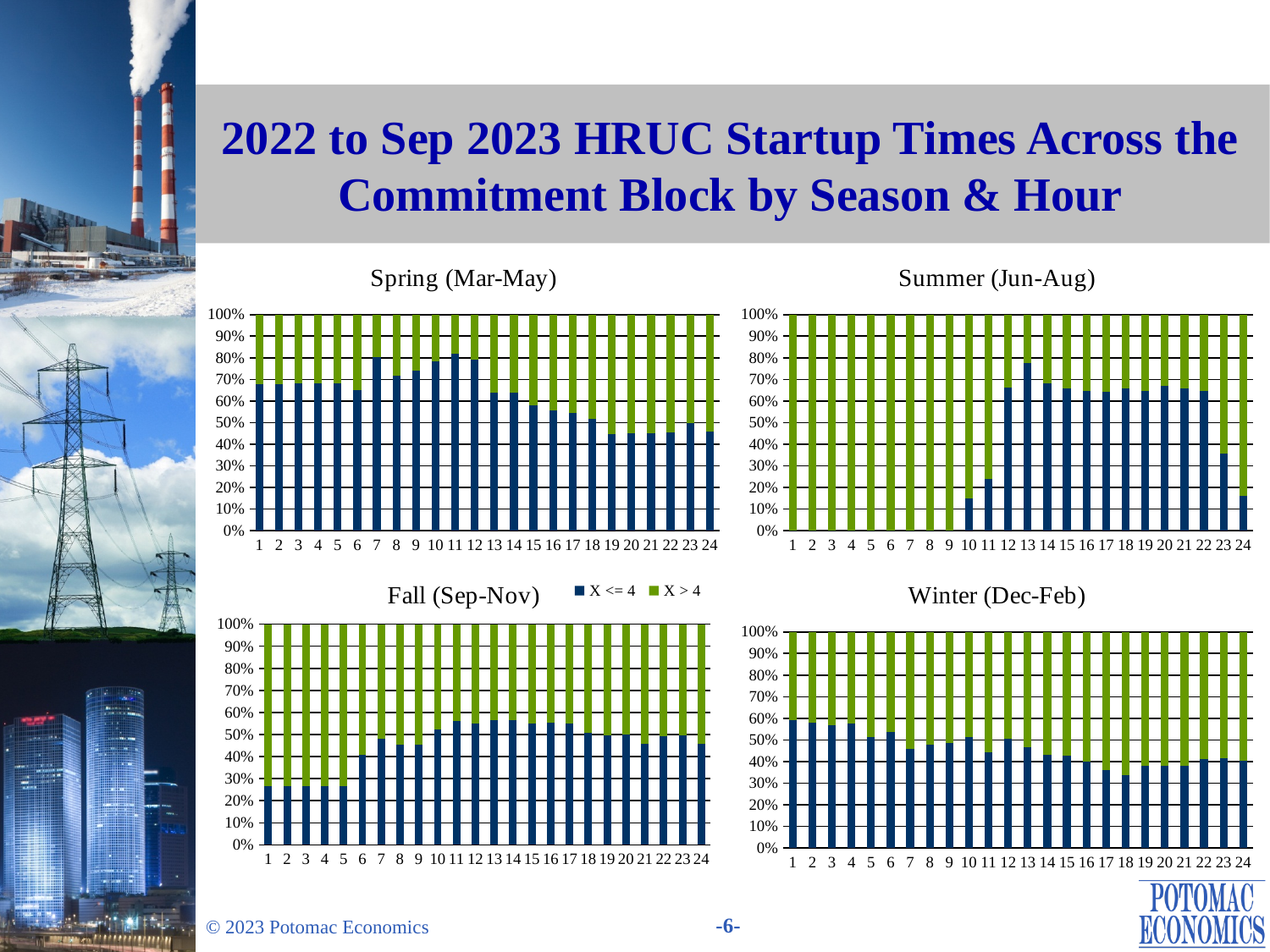
In the Spring (Mar-May) chart, is the X <= 4 share at hour 19 greater or less than 50%? less How many hour categories are shown on the x axis of the Summer (Jun-Aug) chart? 24 In the Summer (Jun-Aug) chart, what is the X > 4 share at hour 1? 100% In the Summer (Jun-Aug) chart, is the X <= 4 share at hour 13 greater or less than 70%? greater In the Fall (Sep-Nov) chart, is the X <= 4 share at hour 1 greater or less than 30%? less In the Winter (Dec-Feb) chart, does the X <= 4 share generally rise or fall from hour 1 to hour 24? Fall How many series does the legend list for these charts? 2 In the Summer (Jun-Aug) chart, which hour has the highest X <= 4 share? 13 In the Fall (Sep-Nov) chart, which is larger, the X <= 4 share at hour 1 or at hour 13? Hour 13 What kind of chart is the Spring (Mar-May) chart? Stacked bar chart What are the two series named in the legend? X <= 4 and X > 4